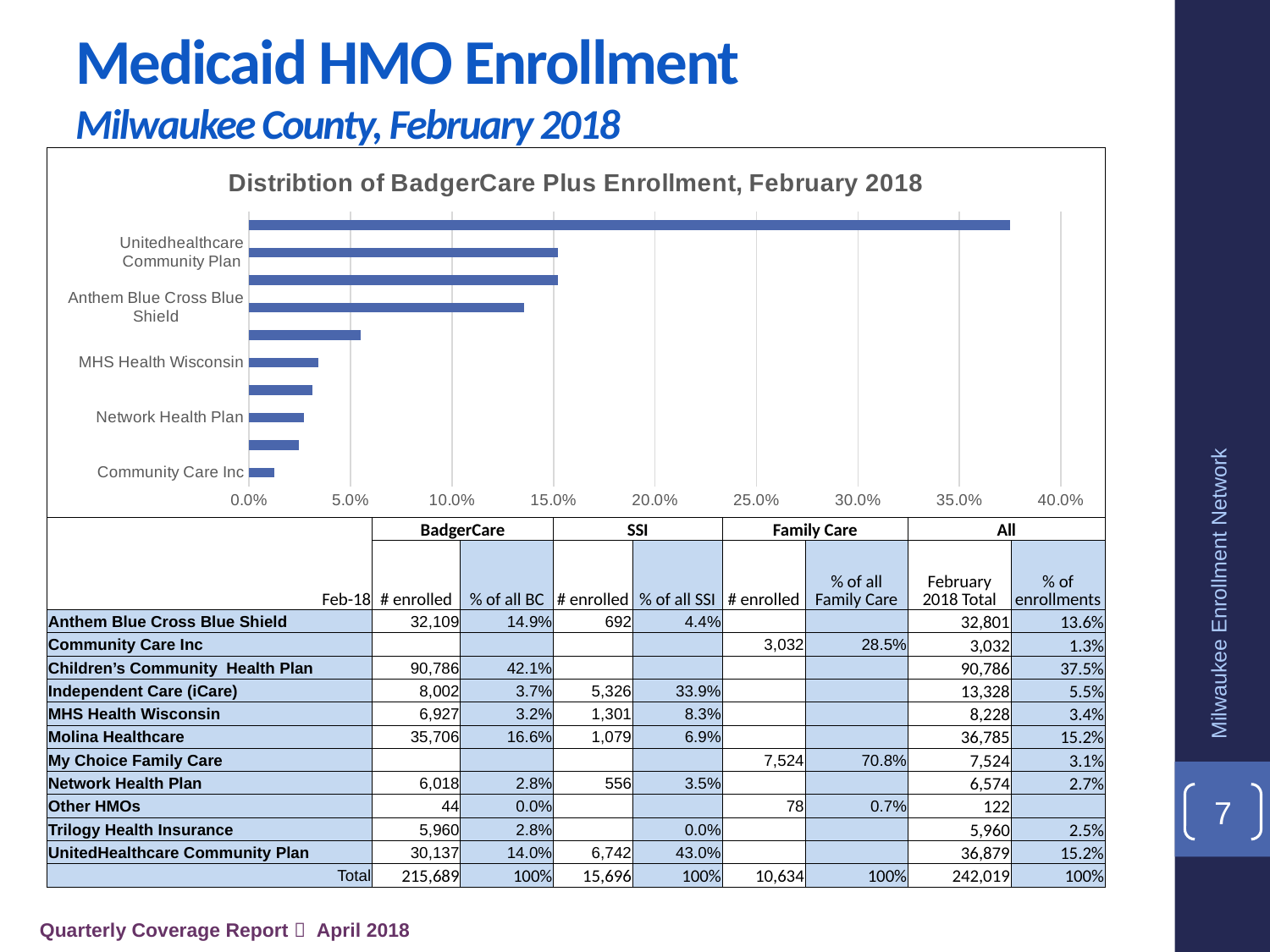
Is the value for Community Care Inc greater or less than 5.0%? less Is the value for Anthem Blue Cross Blue Shield greater or less than 15.0%? less Which has the larger value, Anthem Blue Cross Blue Shield or MHS Health Wisconsin? Anthem Blue Cross Blue Shield What is the highest tick value shown on the chart's horizontal axis? 40.0% What is the title of the chart? Distribtion of BadgerCare Plus Enrollment, February 2018 Among the labeled categories in the chart, which has the shortest bar? Community Care Inc Is the value for MHS Health Wisconsin greater or less than 5.0%? less How many bars are plotted in the chart? 10 Which has the larger value, Network Health Plan or Unitedhealthcare Community Plan? Unitedhealthcare Community Plan What kind of chart is shown on the slide? bar chart